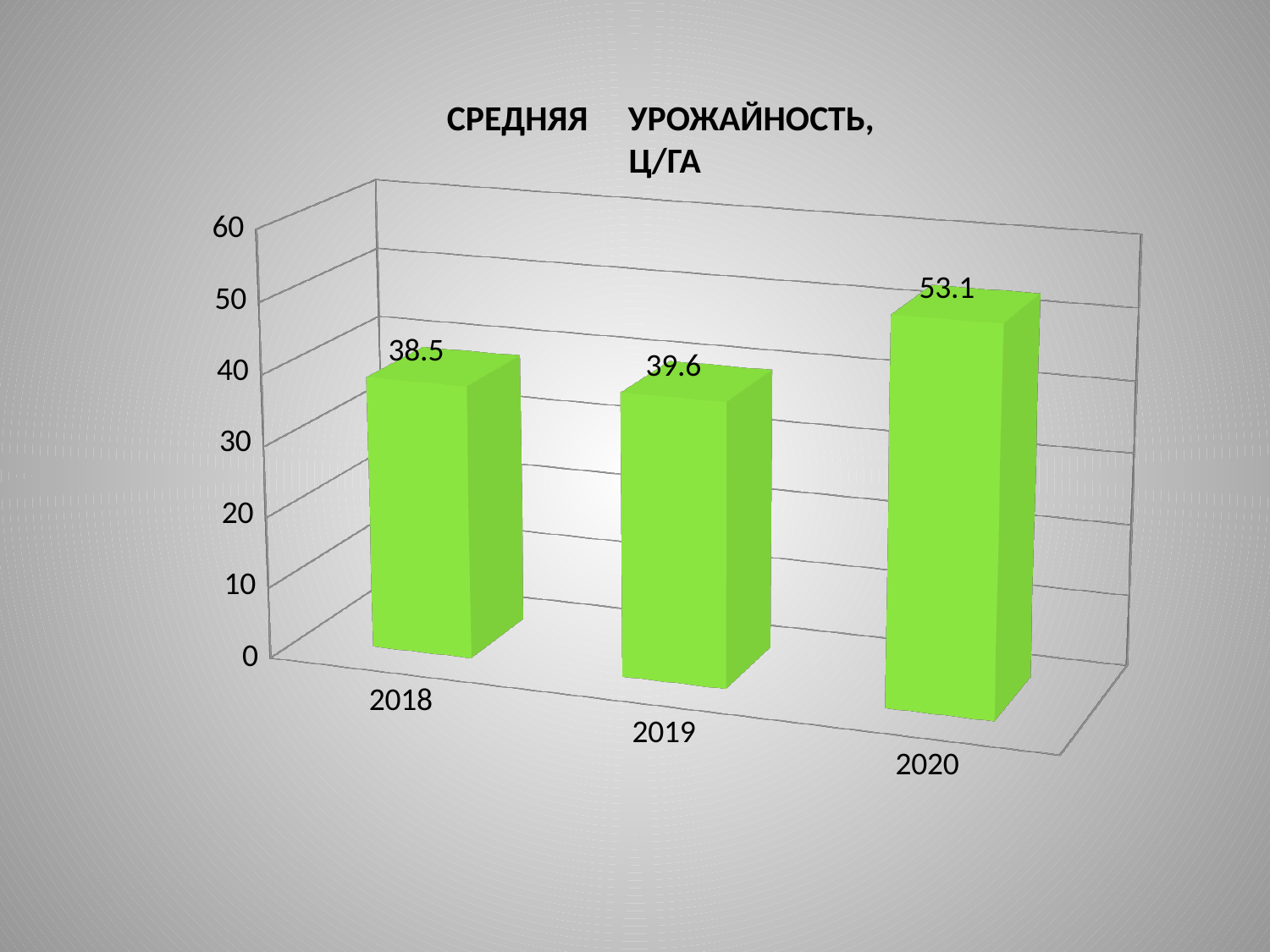
What is the average yield value for 2018? 38.5 What is the average yield value for 2019? 39.6 What is the average yield value for 2020? 53.1 Which is larger, the value for 2020 or the value for 2019? 2020 How many years are shown on the x axis? 3 Is the value for 2020 greater or less than 50? greater Which year has the lowest average yield? 2018 What is the difference between the 2020 and 2018 values? 14.6 What kind of chart is shown on the slide? bar chart What is the difference between the 2019 and 2018 values? 1.1 Do the values rise or fall from 2018 to 2020? rise Which year has the highest average yield? 2020